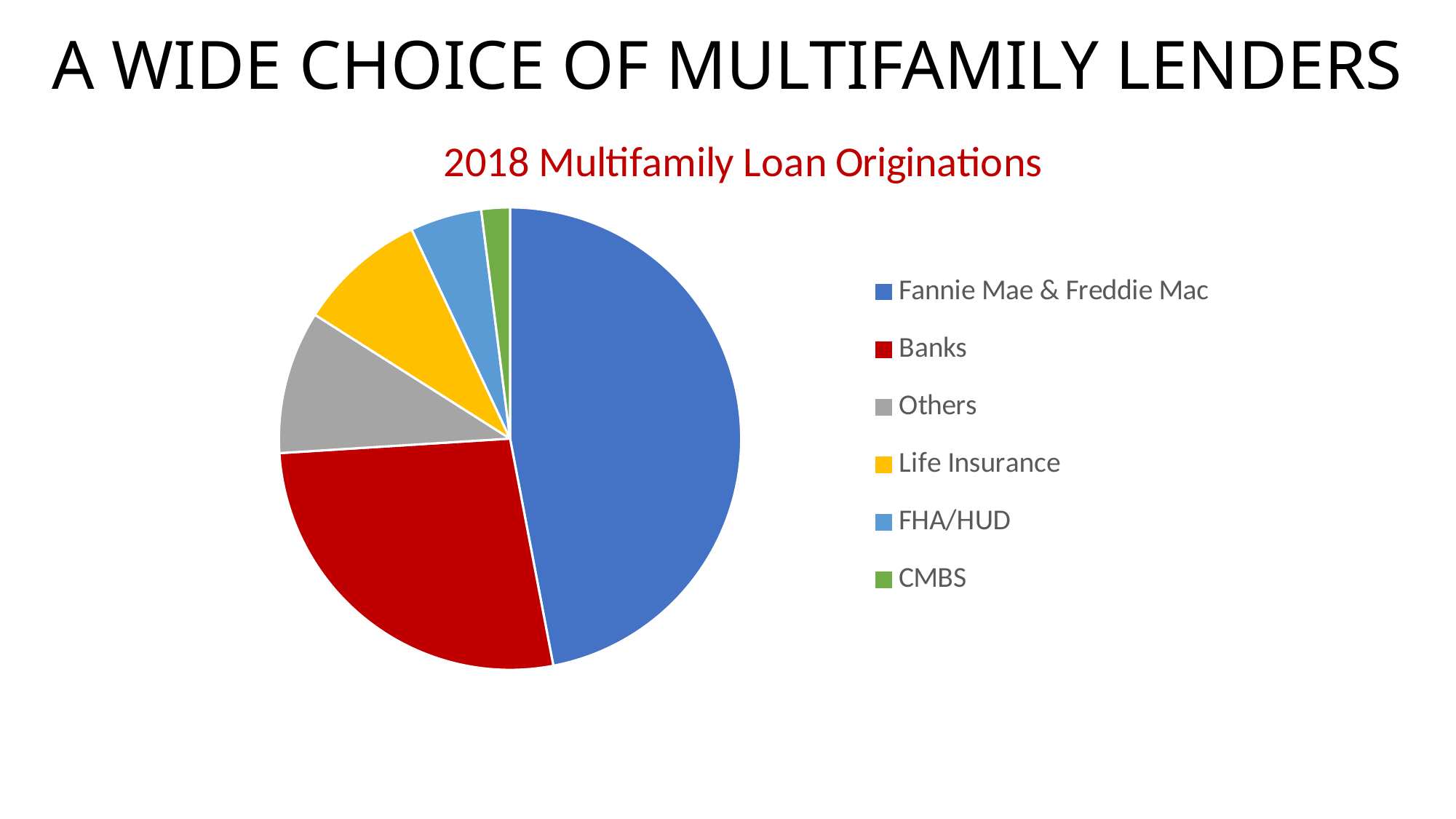
Which slice is larger, Banks or Others? Banks Which category has the smallest slice of the pie? CMBS What is the title of the chart? 2018 Multifamily Loan Originations How many categories does the pie chart show? 6 Which slice is larger, Life Insurance or FHA/HUD? Life Insurance Which category has the largest slice of the pie? Fannie Mae & Freddie Mac Which category is shown in green in the legend? CMBS What kind of chart is shown on the slide? pie chart Which slice is larger, Fannie Mae & Freddie Mac or Banks? Fannie Mae & Freddie Mac